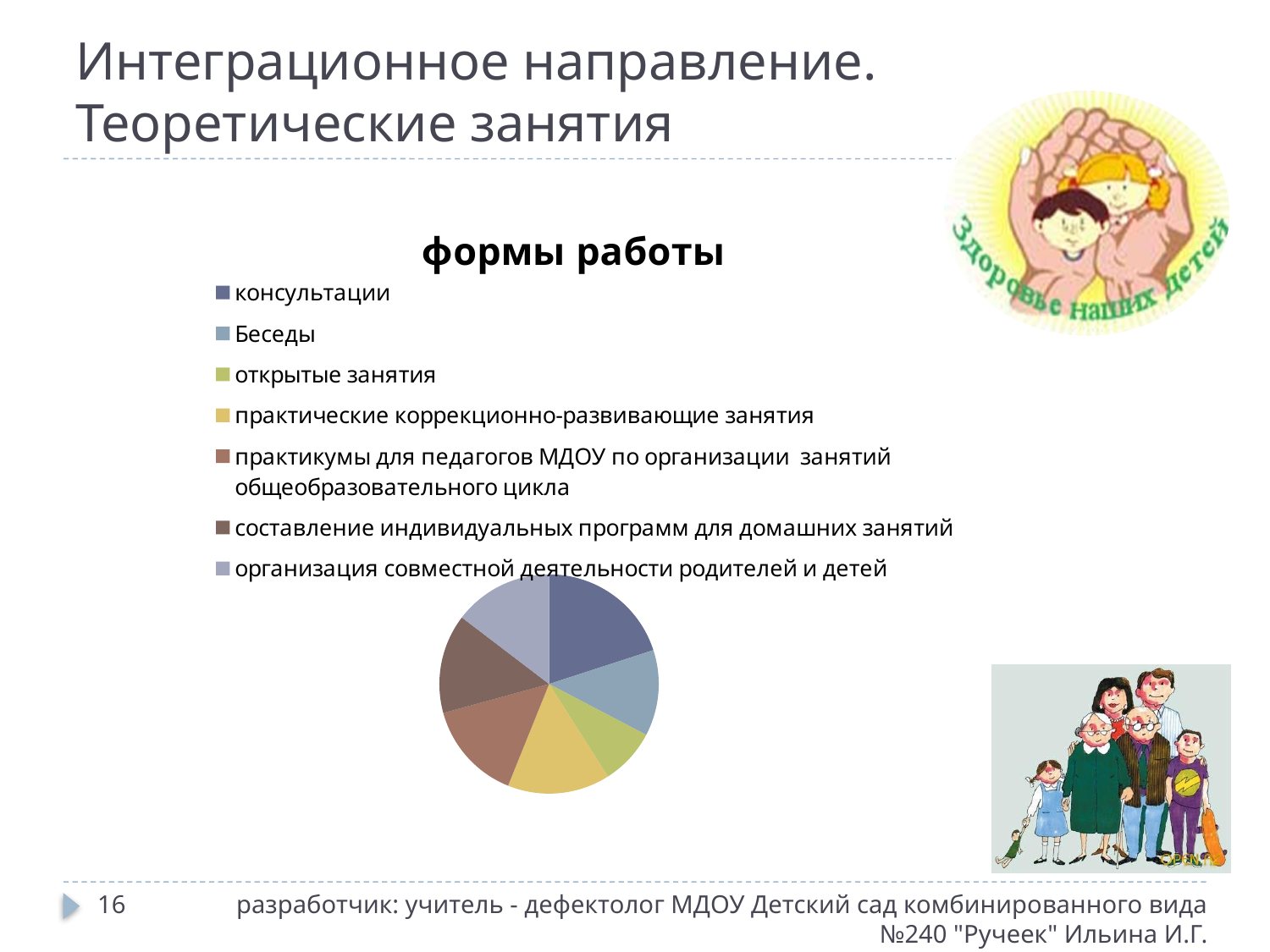
Which slice is larger: составление индивидуальных программ для домашних занятий or открытые занятия? составление индивидуальных программ для домашних занятий How many categories (slices) does the pie chart have? 7 What is the title of the chart? формы работы Which slice is larger: консультации or открытые занятия? консультации Which slice is larger: практические коррекционно-развивающие занятия or Беседы? практические коррекционно-развивающие занятия What kind of chart is shown on the slide? pie chart How many entries does the chart legend list? 7 What colour is the slice for консультации in the pie chart? dark blue